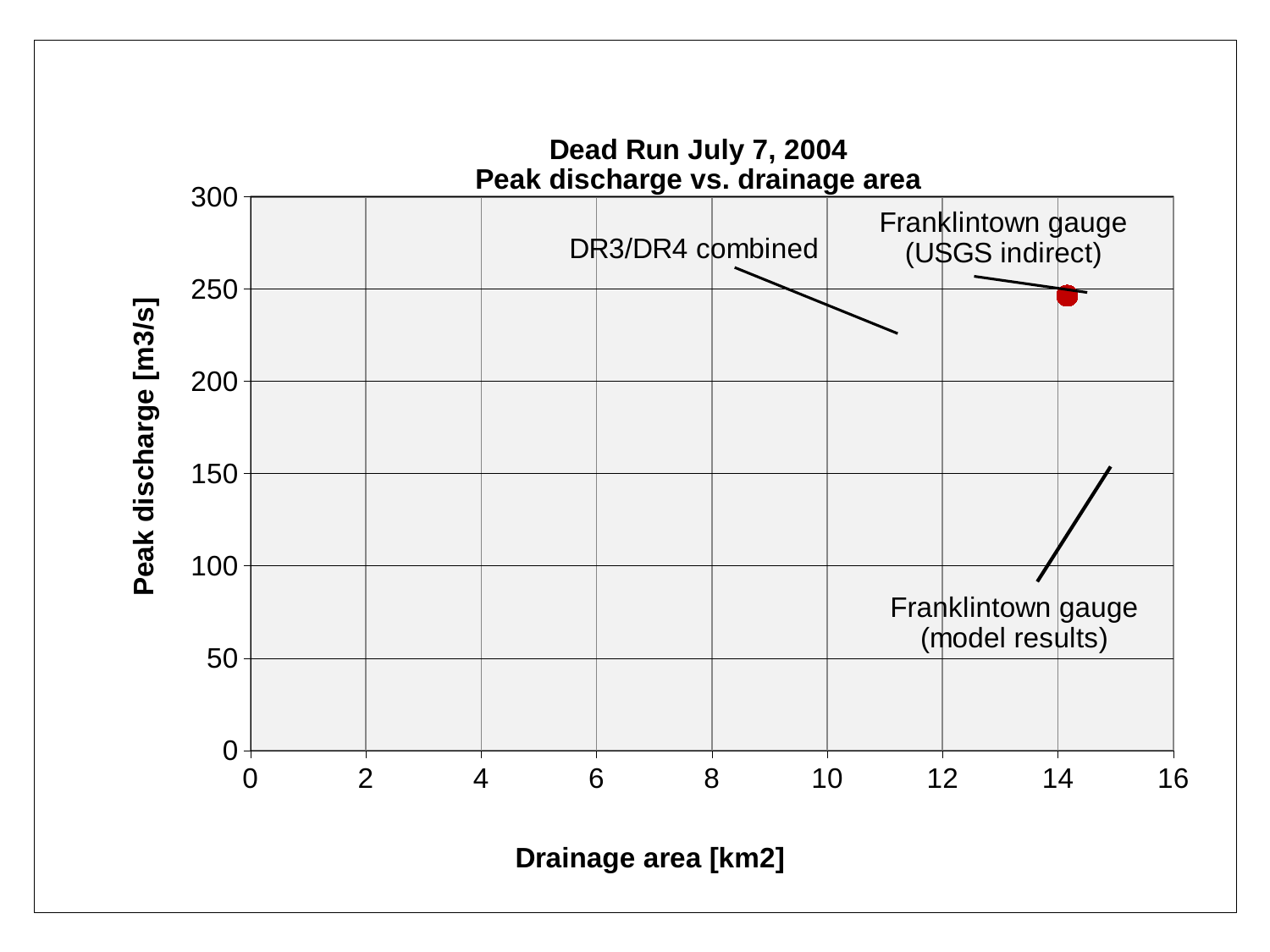
Is the peak discharge for the Franklintown gauge (USGS indirect) point greater or less than 200? greater Is the drainage area for the Franklintown gauge (USGS indirect) point greater or less than 16? less What is the label of the vertical axis? Peak discharge [m3/s] How many data points are plotted on the chart? 1 Is the drainage area for the Franklintown gauge (USGS indirect) point greater or less than 12? greater What kind of chart is shown on the slide? scatter chart What is the title of the chart? Dead Run July 7, 2004 Peak discharge vs. drainage area